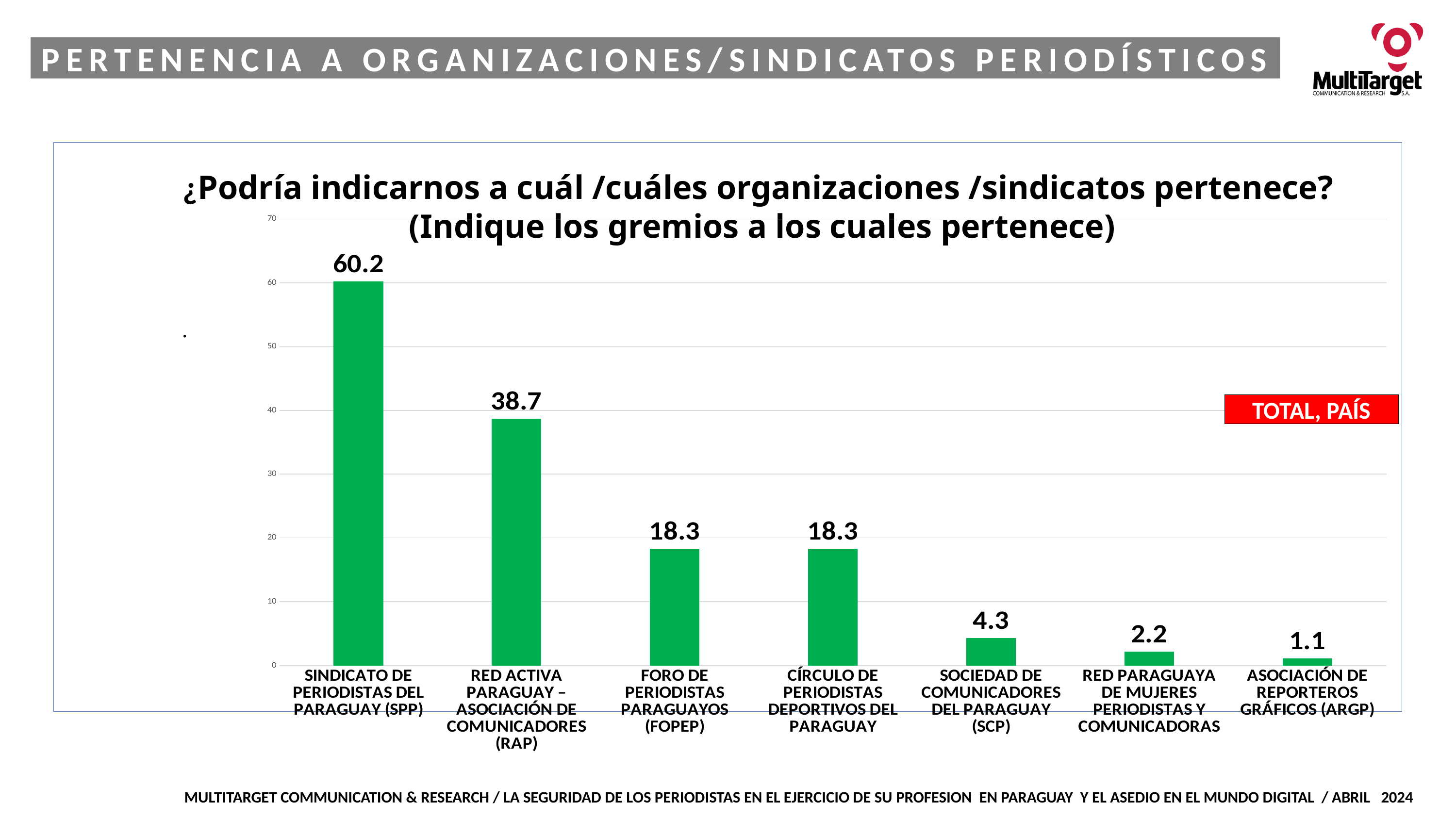
What is the value for SOCIEDAD DE COMUNICADORES DEL PARAGUAY (SCP)? 4.3 Which organization has the lowest value? ASOCIACIÓN DE REPORTEROS GRÁFICOS (ARGP) Is the value for FORO DE PERIODISTAS PARAGUAYOS (FOPEP) greater or less than 20? less What is the difference between the values for SPP and RAP? 21.5 What is the value for RED ACTIVA PARAGUAY – ASOCIACIÓN DE COMUNICADORES (RAP)? 38.7 Which is larger, the value for SOCIEDAD DE COMUNICADORES DEL PARAGUAY (SCP) or RED PARAGUAYA DE MUJERES PERIODISTAS Y COMUNICADORAS? SOCIEDAD DE COMUNICADORES DEL PARAGUAY (SCP) What kind of chart is shown on the slide? bar chart What does the red label on the right of the chart say? TOTAL, PAÍS What is the value for SINDICATO DE PERIODISTAS DEL PARAGUAY (SPP)? 60.2 Which organization has the highest value? SINDICATO DE PERIODISTAS DEL PARAGUAY (SPP) What is the value for ASOCIACIÓN DE REPORTEROS GRÁFICOS (ARGP)? 1.1 How many organizations are shown in the chart? 7